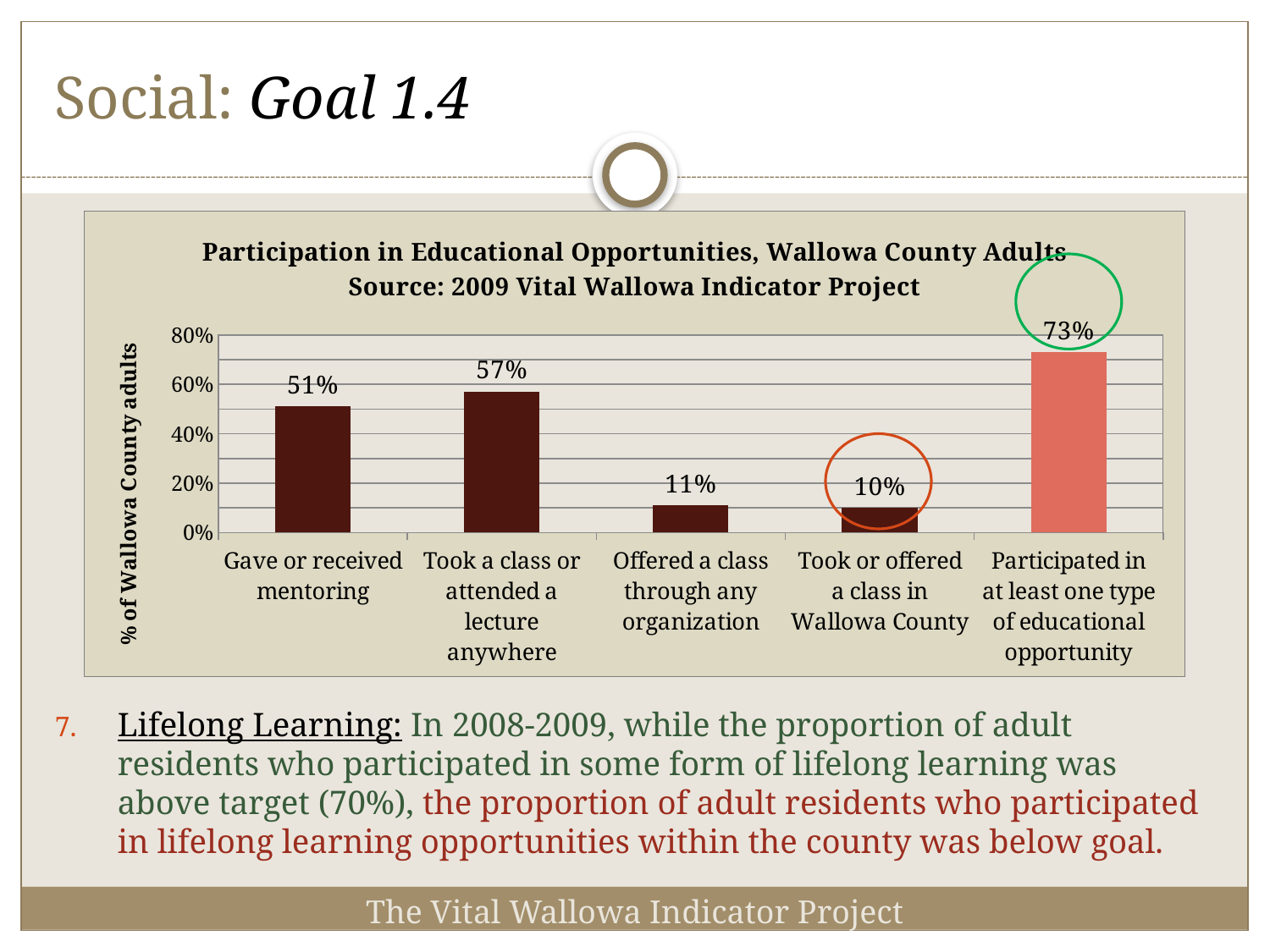
Which is larger: 'Gave or received mentoring' or 'Offered a class through any organization'? Gave or received mentoring Which category has the lowest value in the chart? Took or offered a class in Wallowa County What type of chart is shown on the slide? Bar chart What is the value for 'Took a class or attended a lecture anywhere'? 57% What percentage of Wallowa County adults gave or received mentoring? 51% What is the difference between 'Participated in at least one type of educational opportunity' and 'Took a class or attended a lecture anywhere'? 16% What is the label of the vertical axis of the chart? % of Wallowa County adults What source is cited in the chart title? 2009 Vital Wallowa Indicator Project Which category has the highest value in the chart? Participated in at least one type of educational opportunity What percentage of adults took or offered a class in Wallowa County? 10% How many categories are shown in the chart? 5 Is the value for 'Offered a class through any organization' greater or less than 20%? less